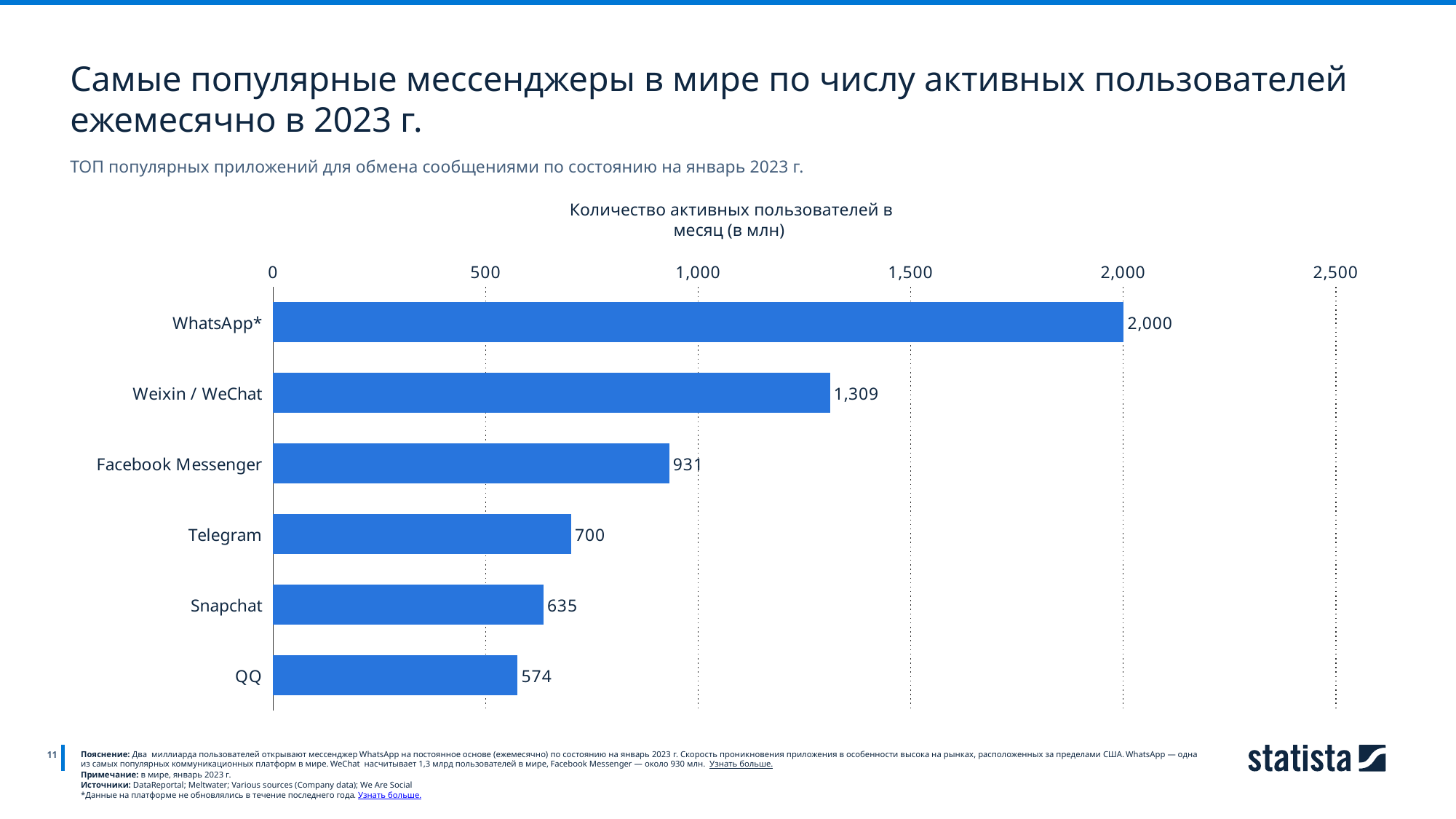
What type of chart is shown on the slide? bar chart What is the number of monthly active users (in millions) for Weixin / WeChat? 1,309 What is the value shown for Snapchat? 635 Is the value for Facebook Messenger greater or less than 1,000? less How many messengers are shown in the chart? 6 What is the difference between the values for WhatsApp* and Weixin / WeChat? 691 Which messenger has the lowest number of monthly active users? QQ What is the title of the chart's axis describing the plotted values? Количество активных пользователей в месяц (в млн) What is the difference between the values for Facebook Messenger and Telegram? 231 Which has more monthly active users, Snapchat or QQ? Snapchat Which messenger has the highest number of monthly active users? WhatsApp* What is the number of monthly active users (in millions) for Telegram? 700